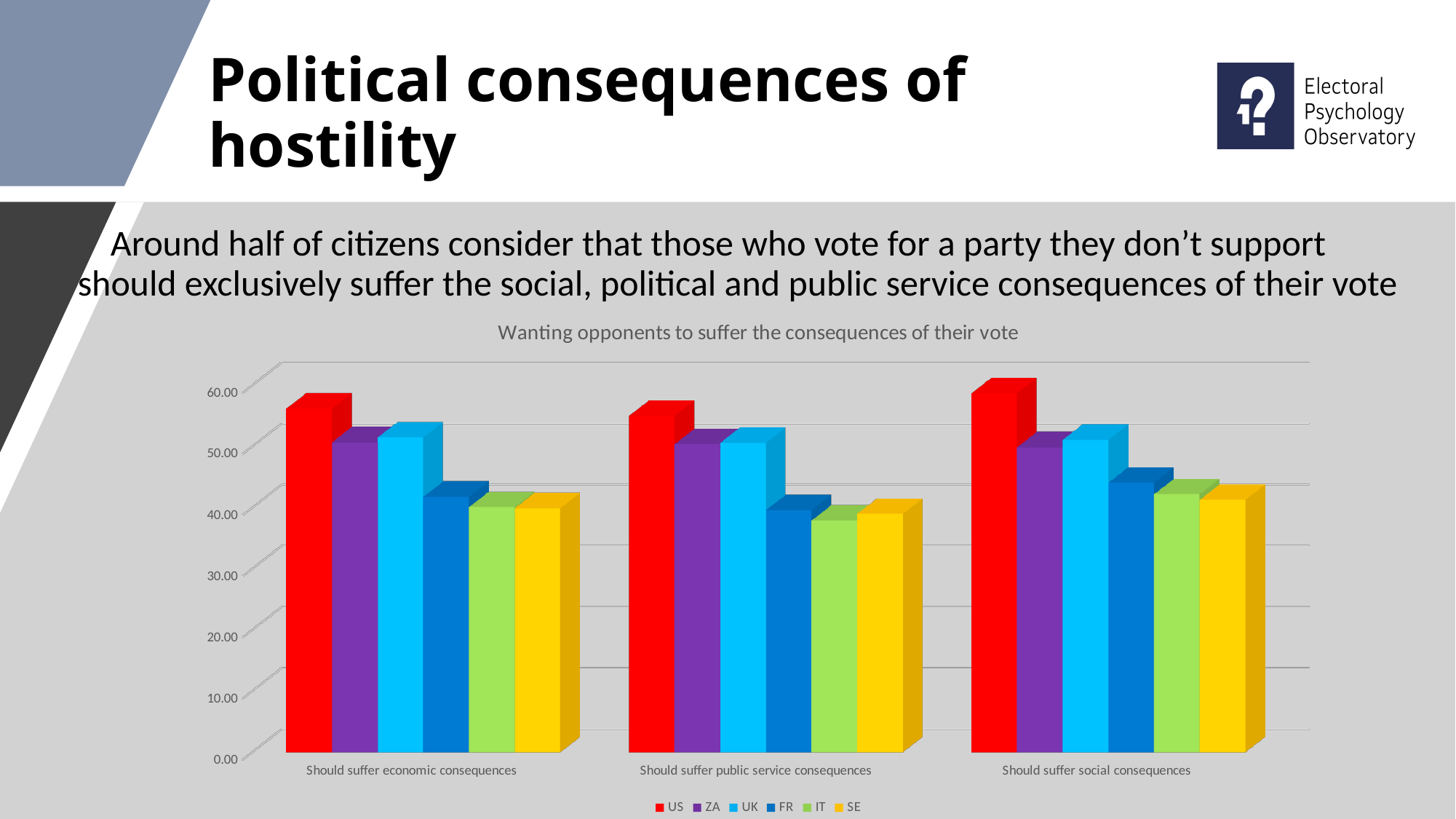
Is the value for US in 'Should suffer economic consequences' greater or less than 50? greater What is the title of the chart? Wanting opponents to suffer the consequences of their vote Which is larger for 'Should suffer economic consequences', the value for US or the value for FR? US How many categories are shown on the x axis? 3 Which country has the highest value for 'Should suffer economic consequences'? US How many series does the legend list? 6 Which country has the highest value for 'Should suffer social consequences'? US Is the value for FR in 'Should suffer public service consequences' greater or less than 50? less Which series is listed first in the legend? US Is the value for ZA in 'Should suffer economic consequences' greater or less than 40? greater What kind of chart is shown on the slide? bar chart